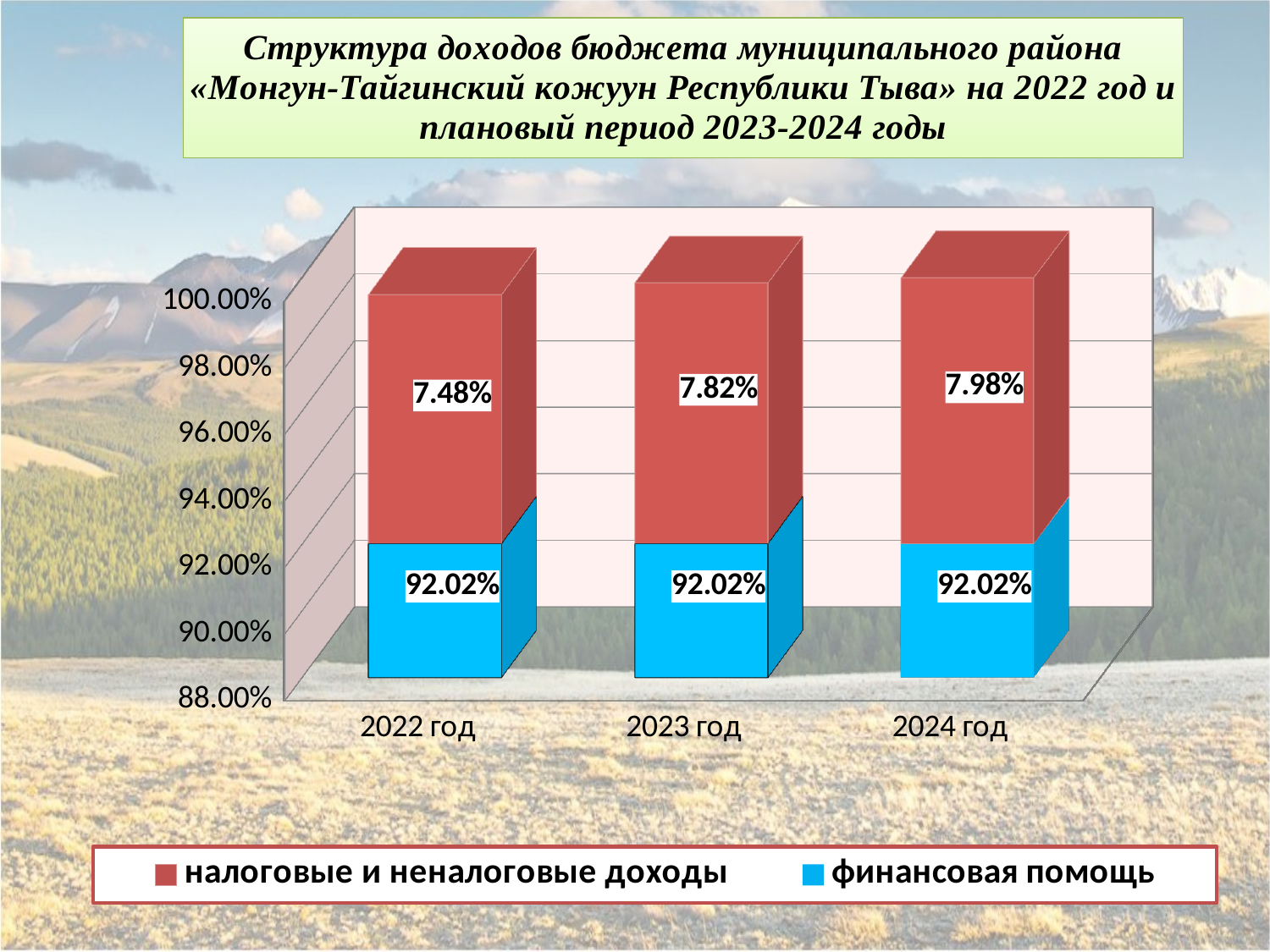
What is the value for налоговые и неналоговые доходы in 2024 год? 7.98% Which year has the highest value for налоговые и неналоговые доходы? 2024 год How many years are shown on the x axis? 3 What kind of chart is shown on the slide? Stacked bar chart Which is larger: the налоговые и неналоговые доходы value for 2023 год or for 2022 год? 2023 год What is the value for налоговые и неналоговые доходы in 2022 год? 7.48% How many series does the legend list? 2 Which series is shown in blue in the legend? финансовая помощь Do the values for налоговые и неналоговые доходы rise or fall from 2022 год to 2024 год? Rise What is the difference between the налоговые и неналоговые доходы values for 2024 год and 2022 год? 0.50% Which year has the lowest value for налоговые и неналоговые доходы? 2022 год What is the value for финансовая помощь in 2023 год? 92.02%